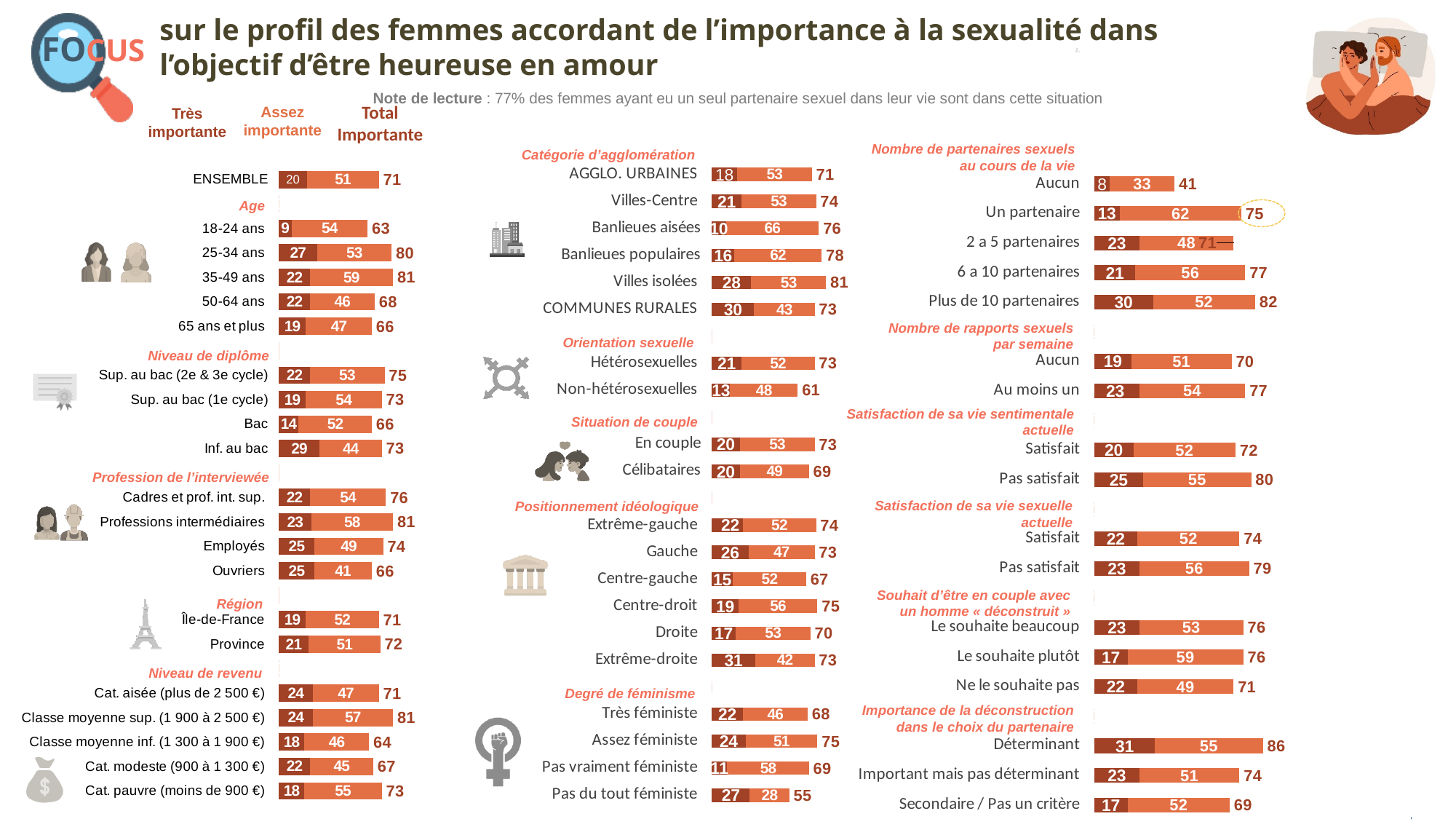
In the 'Degré de féminisme' chart, what is the total of the stacked bar for 'Pas du tout féministe'? 55 In the left-hand chart, what is the Total Importante value for ENSEMBLE? 71 In the 'Degré de féminisme' chart, how many categories are shown? 4 In the 'Nombre de partenaires sexuels au cours de la vie' chart, which category has the lowest total? Aucun In the Age chart, what is the Très importante value for 25-34 ans? 27 What kind of chart is used on this slide to show the values? Bar chart In the 'Importance de la déconstruction dans le choix du partenaire' chart, which category has the highest total? Déterminant In the 'Nombre de partenaires sexuels au cours de la vie' chart, what is the difference between the totals for 'Plus de 10 partenaires' and 'Aucun'? 41 In the 'Catégorie d'agglomération' chart, which has the larger total: Villes isolées or AGGLO. URBAINES? Villes isolées According to the legend at the top of the slide, what does the dark segment of each bar represent? Très importante In the Age chart, which age group has the highest Total Importante value? 35-49 ans In the 'Orientation sexuelle' chart, what is the Assez importante value for Non-hétérosexuelles? 48